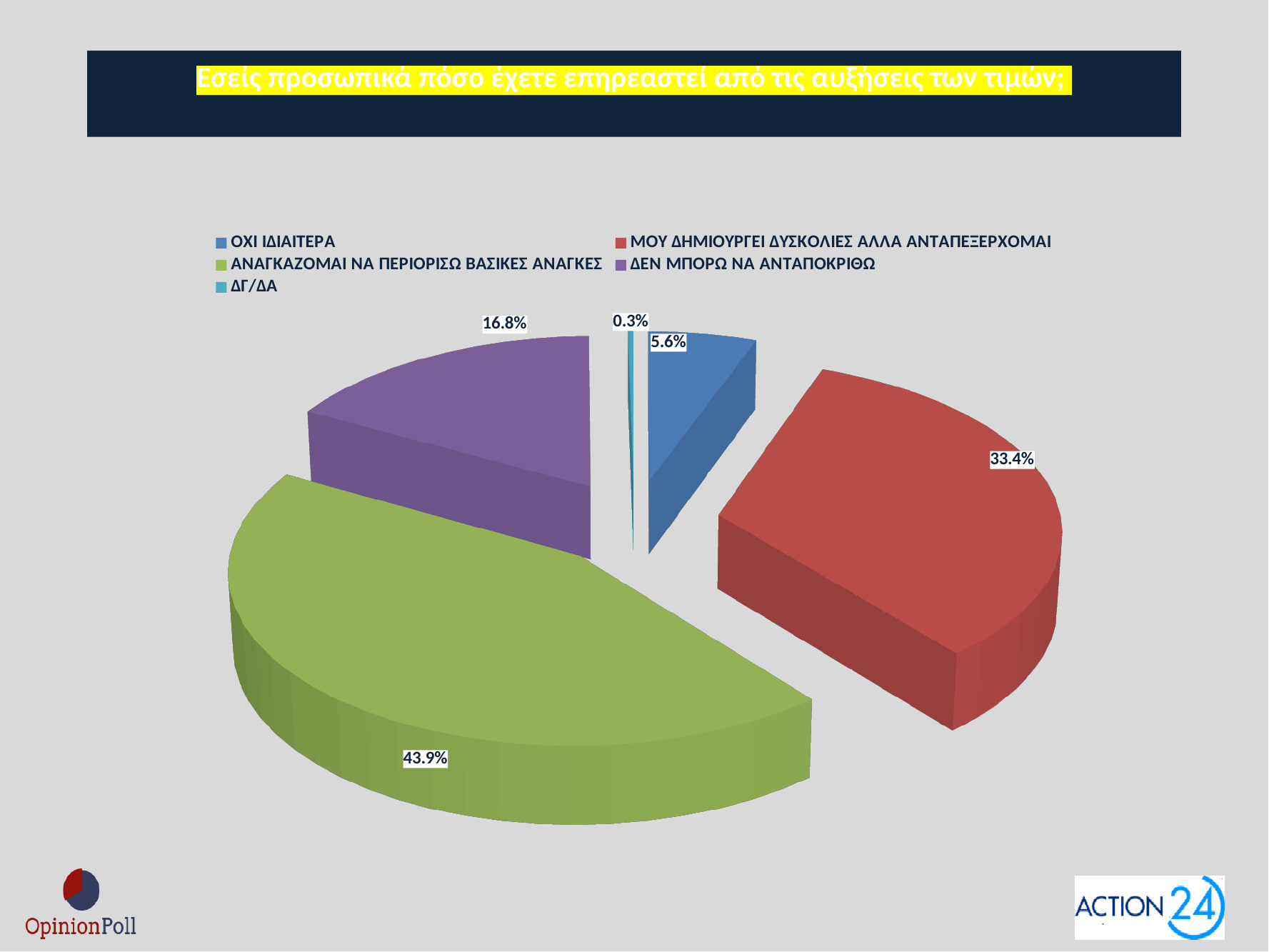
Which category has the smallest share of the pie? ΔΓ/ΔΑ What percentage is shown for ΔΕΝ ΜΠΟΡΩ ΝΑ ΑΝΤΑΠΟΚΡΙΘΩ? 16.8% What percentage is shown for ΔΓ/ΔΑ? 0.3% What percentage is shown for ΑΝΑΓΚΑΖΟΜΑΙ ΝΑ ΠΕΡΙΟΡΙΣΩ ΒΑΣΙΚΕΣ ΑΝΑΓΚΕΣ? 43.9% What is the difference in percentage points between ΑΝΑΓΚΑΖΟΜΑΙ ΝΑ ΠΕΡΙΟΡΙΣΩ ΒΑΣΙΚΕΣ ΑΝΑΓΚΕΣ and ΜΟΥ ΔΗΜΙΟΥΡΓΕΙ ΔΥΣΚΟΛΙΕΣ ΑΛΛΑ ΑΝΤΑΠΕΞΕΡΧΟΜΑΙ? 10.5 What colour is the slice for ΔΕΝ ΜΠΟΡΩ ΝΑ ΑΝΤΑΠΟΚΡΙΘΩ? Purple Which is larger: the share for ΔΕΝ ΜΠΟΡΩ ΝΑ ΑΝΤΑΠΟΚΡΙΘΩ or the share for ΟΧΙ ΙΔΙΑΙΤΕΡΑ? ΔΕΝ ΜΠΟΡΩ ΝΑ ΑΝΤΑΠΟΚΡΙΘΩ What percentage is shown for ΟΧΙ ΙΔΙΑΙΤΕΡΑ? 5.6% What percentage is shown for ΜΟΥ ΔΗΜΙΟΥΡΓΕΙ ΔΥΣΚΟΛΙΕΣ ΑΛΛΑ ΑΝΤΑΠΕΞΕΡΧΟΜΑΙ? 33.4% How many categories does the pie chart have? 5 Which category has the largest share of the pie? ΑΝΑΓΚΑΖΟΜΑΙ ΝΑ ΠΕΡΙΟΡΙΣΩ ΒΑΣΙΚΕΣ ΑΝΑΓΚΕΣ What type of chart is shown on the slide? Pie chart